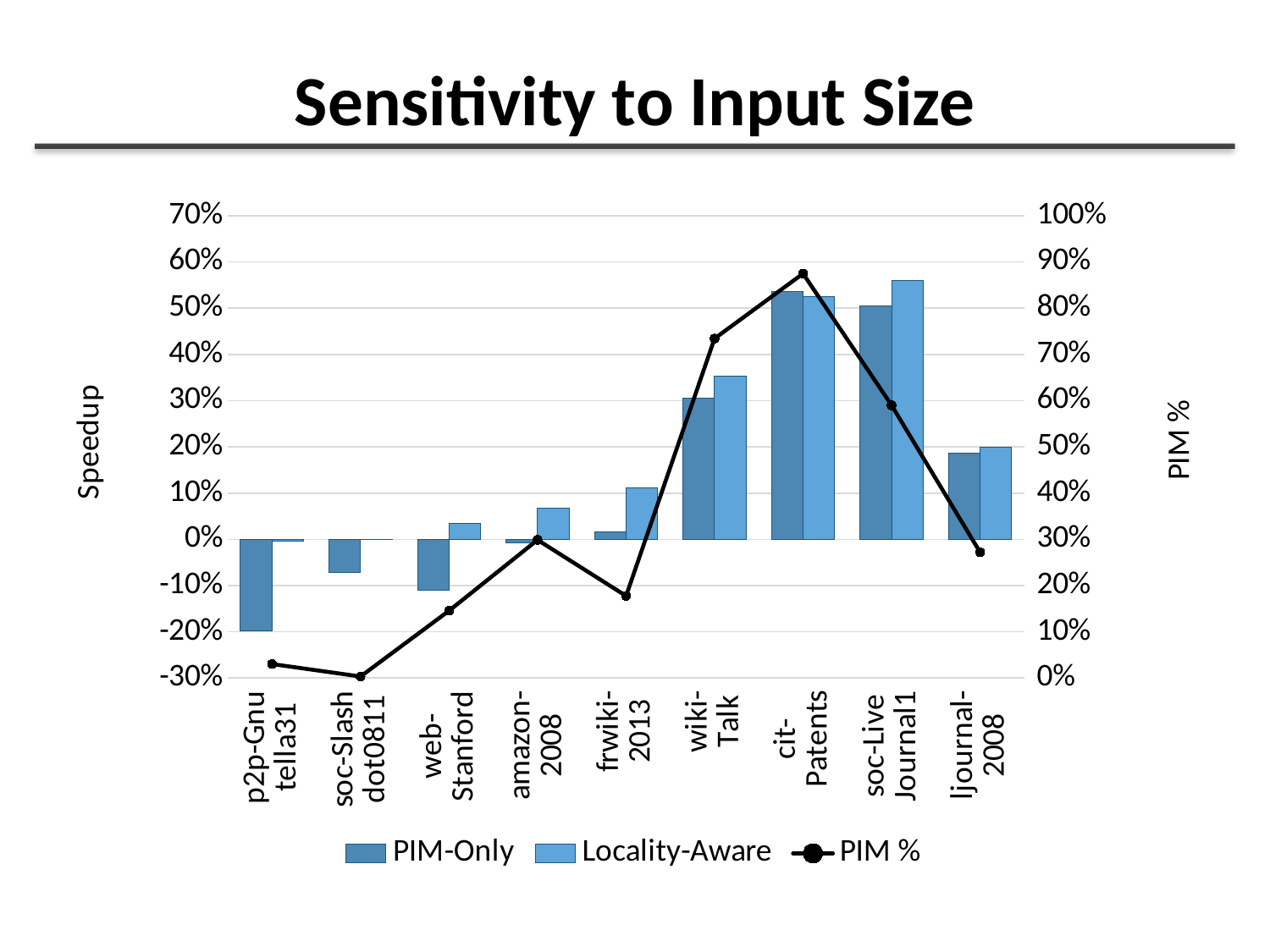
How many categories are shown on the x axis of the chart? 9 Is the PIM % value for frwiki-2013 greater or less than 30%? less Which category has the lowest PIM-Only speedup? p2p-Gnutella31 For web-Stanford, which is larger: the PIM-Only speedup or the Locality-Aware speedup? Locality-Aware Is the PIM % value for wiki-Talk greater or less than 60%? greater How many series does the legend list? 3 Which category has the highest Locality-Aware speedup? soc-LiveJournal1 What kind of chart is this? Bar chart with a line series Is the PIM-Only speedup for p2p-Gnutella31 greater or less than -10%? less Which category has the highest PIM % value? cit-Patents What is the title of the left vertical axis? Speedup